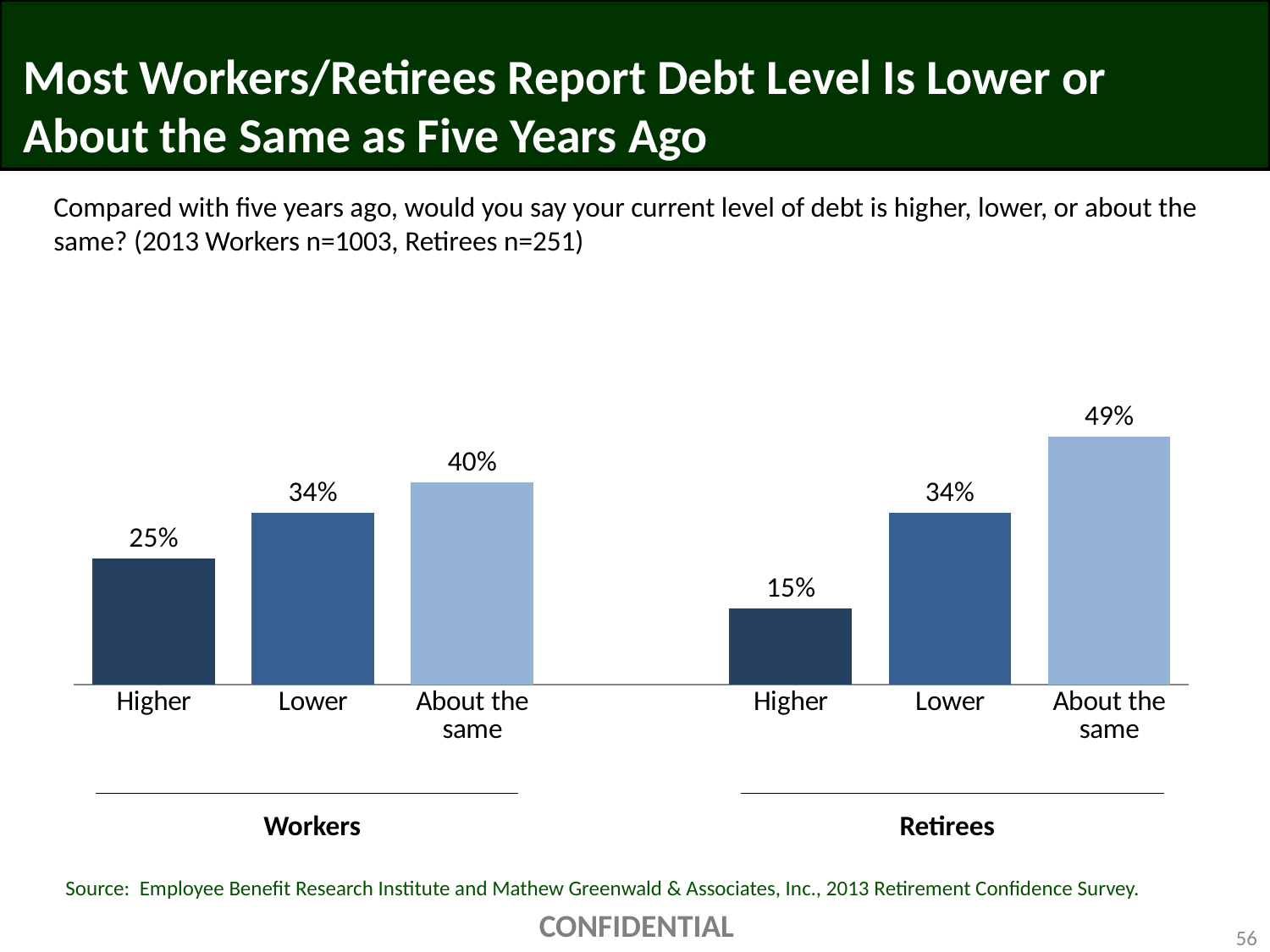
What is the difference between the Retirees' and Workers' percentages for About the same? 9% How many bars are plotted in the chart in total? 6 Which response has the lowest percentage among Retirees? Higher Which is larger: the Workers' Lower percentage or the Workers' Higher percentage? Lower What type of chart is shown on the slide? Bar chart What percentage of Workers report their debt level is Higher than five years ago? 25% Which response has the highest percentage among Workers? About the same What is the difference between the Workers' Higher and Retirees' Higher percentages? 10% What percentage of Retirees say their debt level is About the same as five years ago? 49% What are the two group labels shown beneath the bars? Workers and Retirees What percentage of Retirees report their debt level is Lower? 34% Do the values for Retirees rise or fall moving from Higher to Lower to About the same? Rise